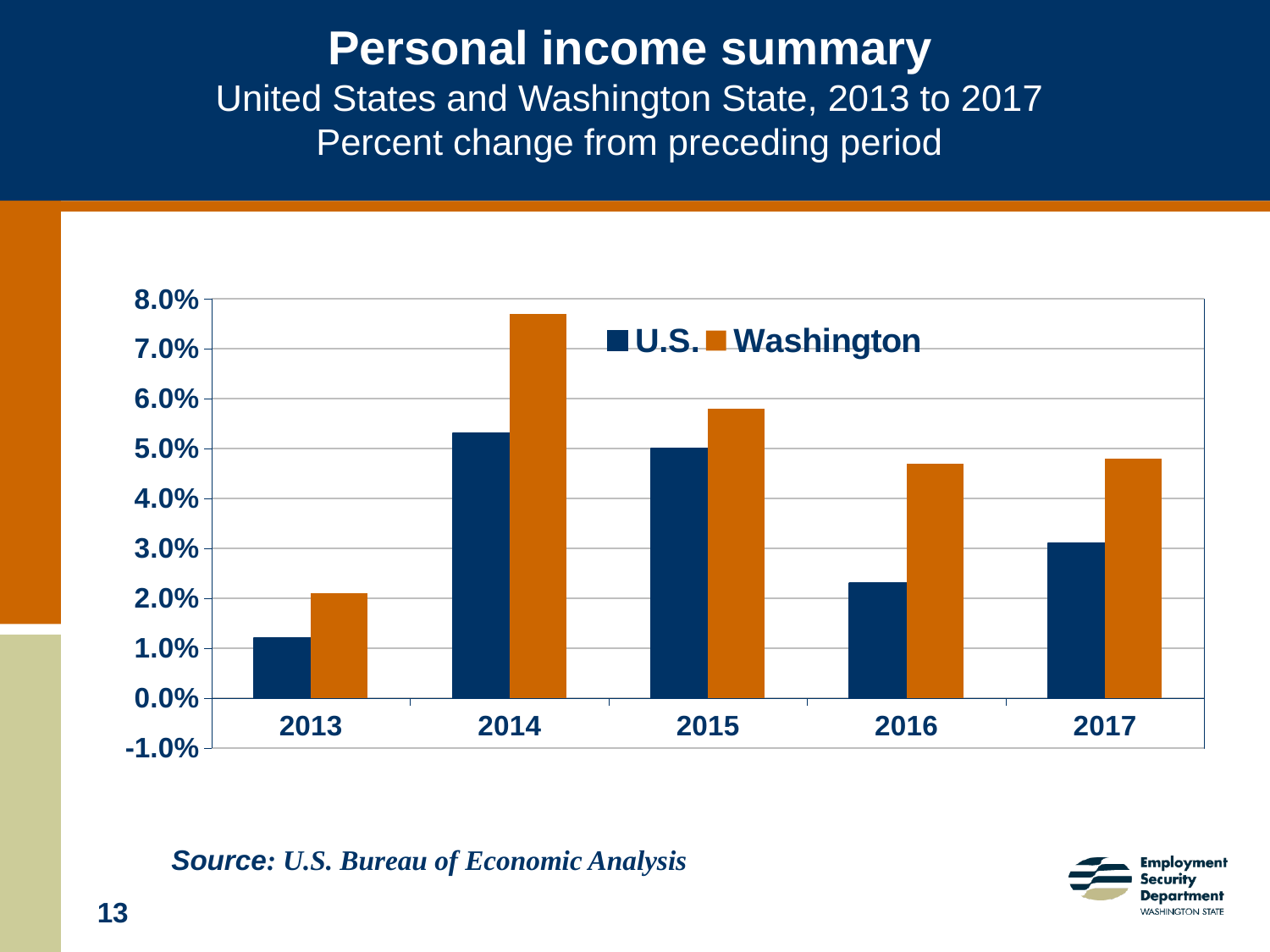
Is the Washington value for 2014 greater or less than 7.0%? greater Do the U.S. values rise or fall from 2014 to 2016? fall Is the Washington value for 2016 greater or less than 5.0%? less Is the U.S. value for 2016 greater or less than 3.0%? less How many years are shown on the x axis? 5 Which is larger, the U.S. value for 2014 or the U.S. value for 2015? 2014 How many series does the legend list? 2 What colour are the Washington bars? orange In which year is the Washington value highest? 2014 What kind of chart is shown on the slide? bar chart In which year is the U.S. value lowest? 2013 In which year is the Washington value lowest? 2013